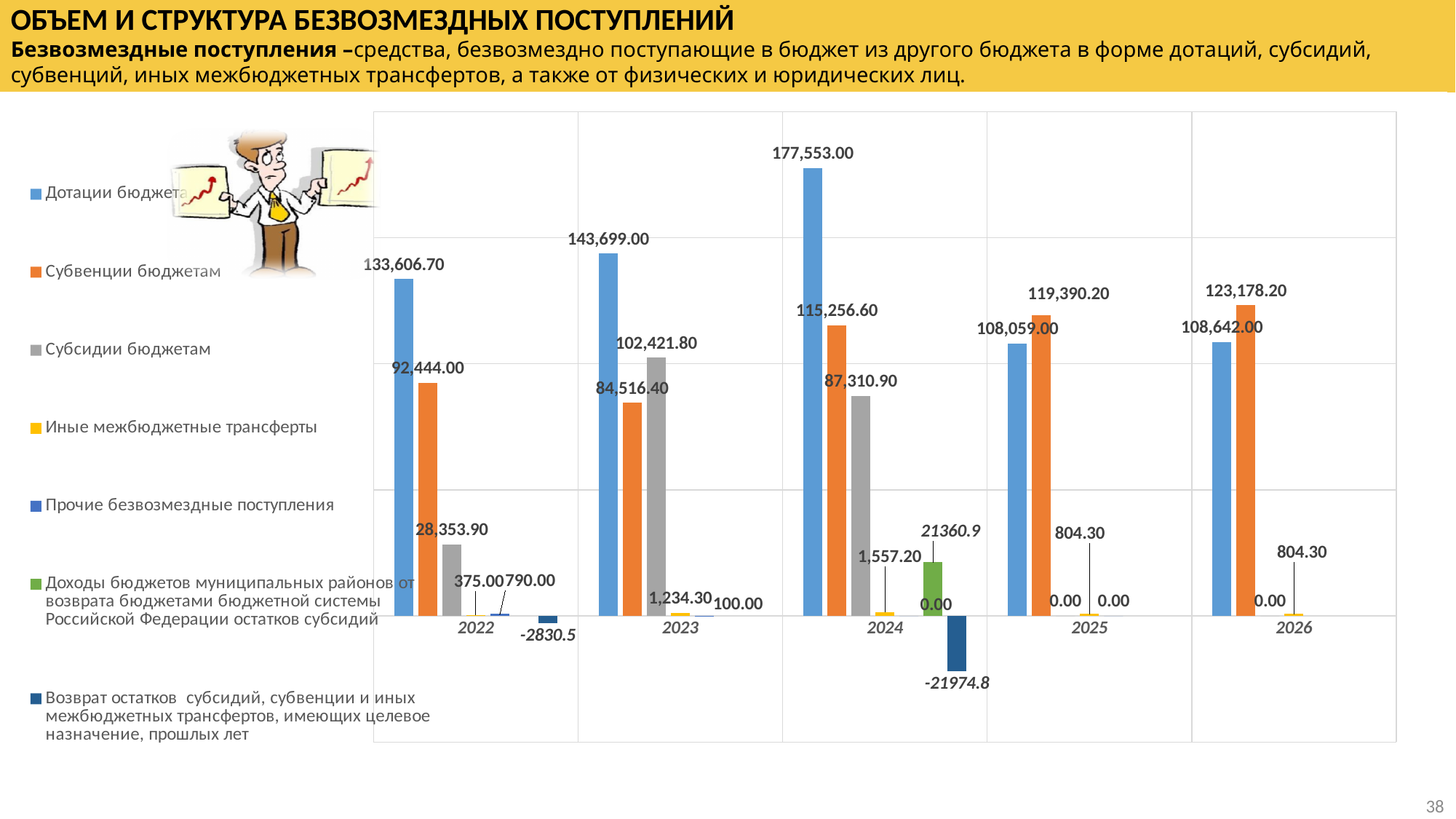
What is the value of Иные межбюджетные трансферты in 2025? 804.30 What is the value of Субсидии бюджетам in 2023? 102,421.80 What kind of chart is shown on the slide? Bar chart How many series does the legend list? 7 What is the value of Субвенции бюджетам in 2026? 123,178.20 Does Субвенции бюджетам rise or fall from 2024 to 2026? Rise What is the value of Дотации бюджета in 2024? 177,553.00 How many years are shown on the x axis? 5 In which year is Дотации бюджета highest? 2024 Which is larger in 2025: Дотации бюджета or Субвенции бюджетам? Субвенции бюджетам In which year is Субвенции бюджетам lowest? 2023 What is the difference between Дотации бюджета in 2024 and in 2023? 33,854.00